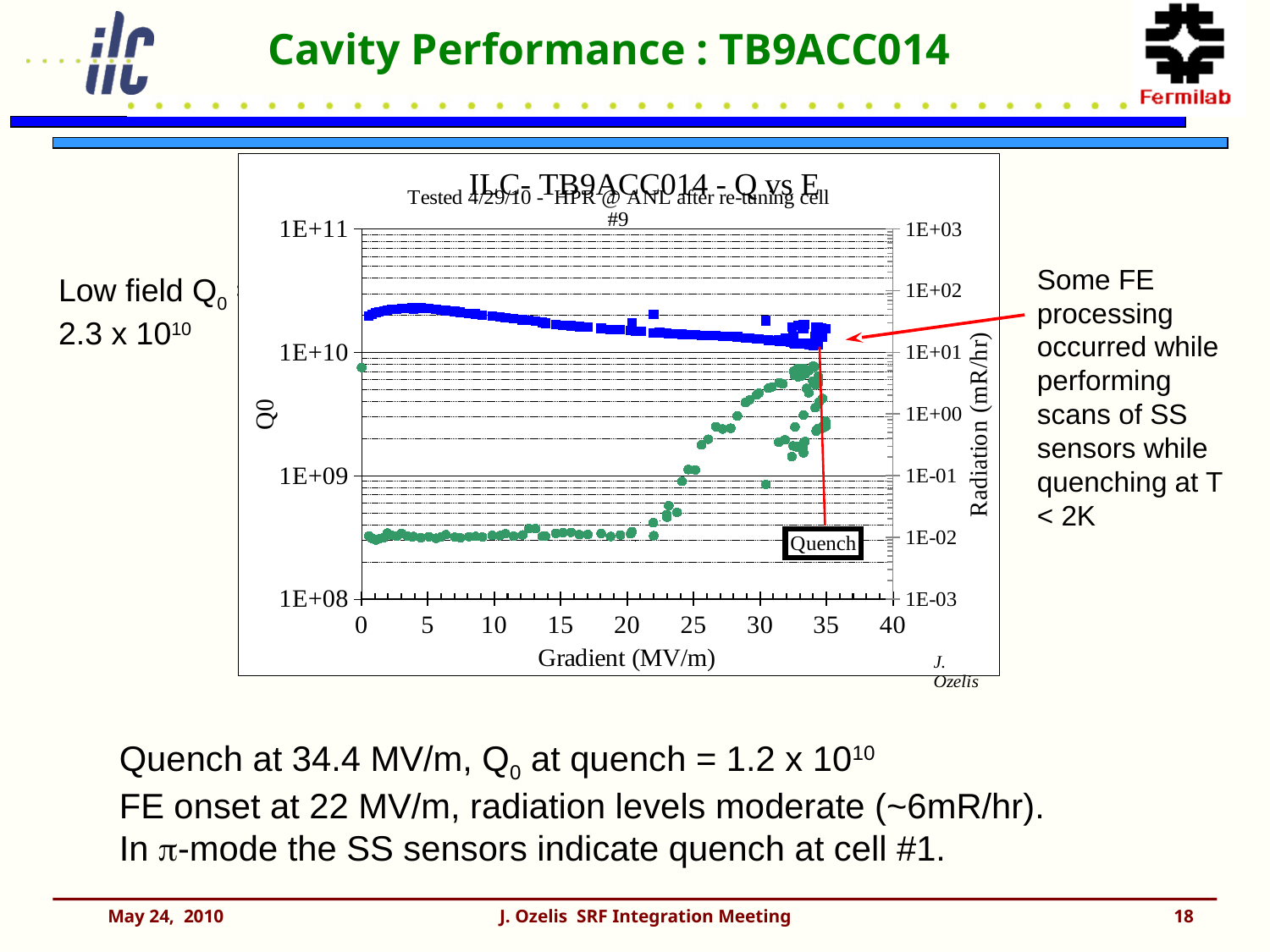
What kind of chart is shown on the slide? scatter chart How many data series are plotted on the chart? 2 What quantity is plotted on the x axis of the chart? Gradient (MV/m) Is the radiation value at a gradient of 10 MV/m greater or less than 1E-01 mR/hr? less Does the radiation series rise or fall as the gradient increases from 22 to 32 MV/m? rise Which series has the higher values on its axis at a gradient of 20 MV/m, Q0 or radiation? Q0 Is the Q0 value at a gradient of 30 MV/m greater or less than 1E+11? less Does the Q0 series rise or fall as the gradient increases from 5 to 35 MV/m? fall What is the title of the chart? ILC- TB9ACC014 - Q vs E Is the Q0 value at a gradient of 5 MV/m greater or less than 1E+10? greater